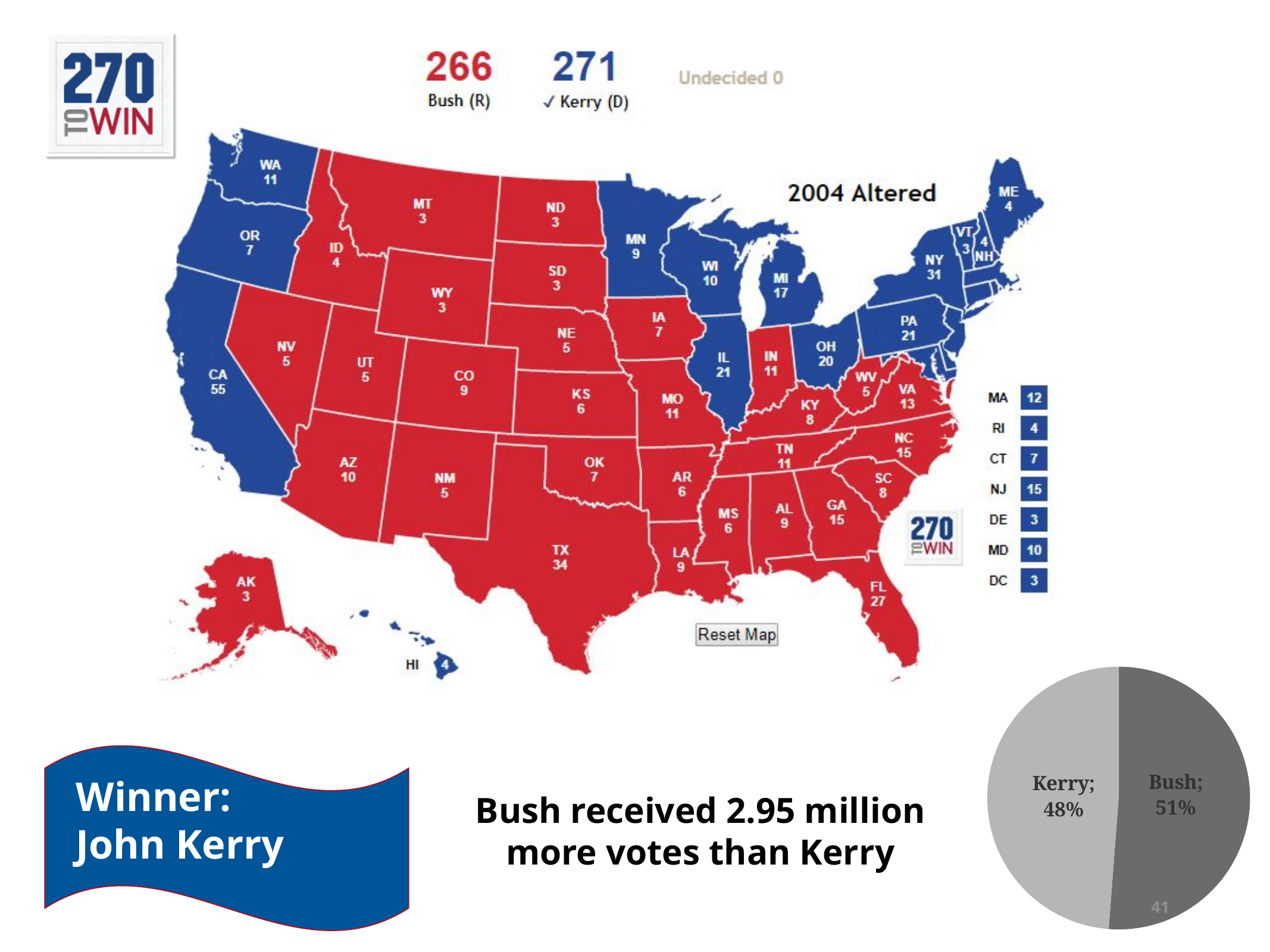
In the pie chart, is Bush's share greater or less than 50%? greater On the electoral map, what is the difference between Kerry's and Bush's electoral vote totals? 5 In the pie chart, what share is shown for Bush? 51% In the pie chart, what share is shown for Kerry? 48% On the electoral map, how many electoral votes are shown for Kerry (D)? 271 In the pie chart, which candidate has the smallest slice? Kerry On the electoral map, how many electoral votes are shown for CA? 55 On the electoral map, how many electoral votes are shown for Bush (R)? 266 In the pie chart, what is the difference between Bush's share and Kerry's share? 3% What kind of chart is shown in the bottom right of the slide? pie chart In the pie chart, which slice is larger, Bush or Kerry? Bush How many slices does the pie chart have? 2